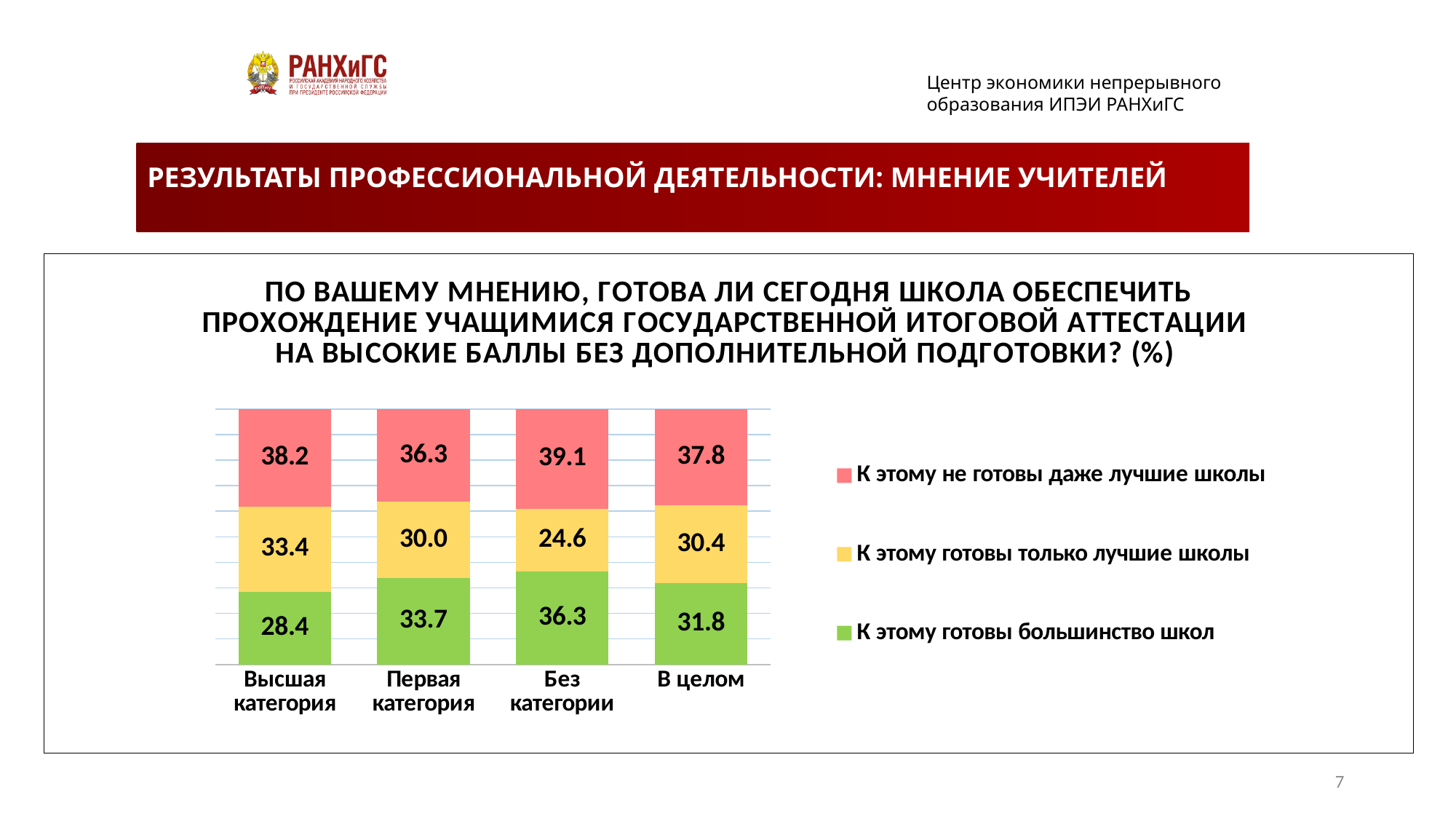
Which category has the lowest value for "К этому готовы большинство школ"? Высшая категория How many categories are shown on the x axis? 4 What is the total of the stacked bar for "В целом"? 100.0 How many series does the legend list? 3 What is the difference between the "К этому готовы только лучшие школы" values for "Высшая категория" and "Без категории"? 8.8 Which is larger: the "К этому не готовы даже лучшие школы" value for "Без категории" or for "Первая категория"? Без категории What is the value for "К этому готовы только лучшие школы" in the "Первая категория" category? 30.0 What is the value for "К этому готовы большинство школ" in the "Без категории" category? 36.3 What kind of chart is shown on the slide? Stacked bar chart What is the value for "К этому не готовы даже лучшие школы" in the "В целом" category? 37.8 Which colour represents "К этому готовы большинство школ" in the legend? Green Which category has the highest value for "К этому готовы только лучшие школы"? Высшая категория